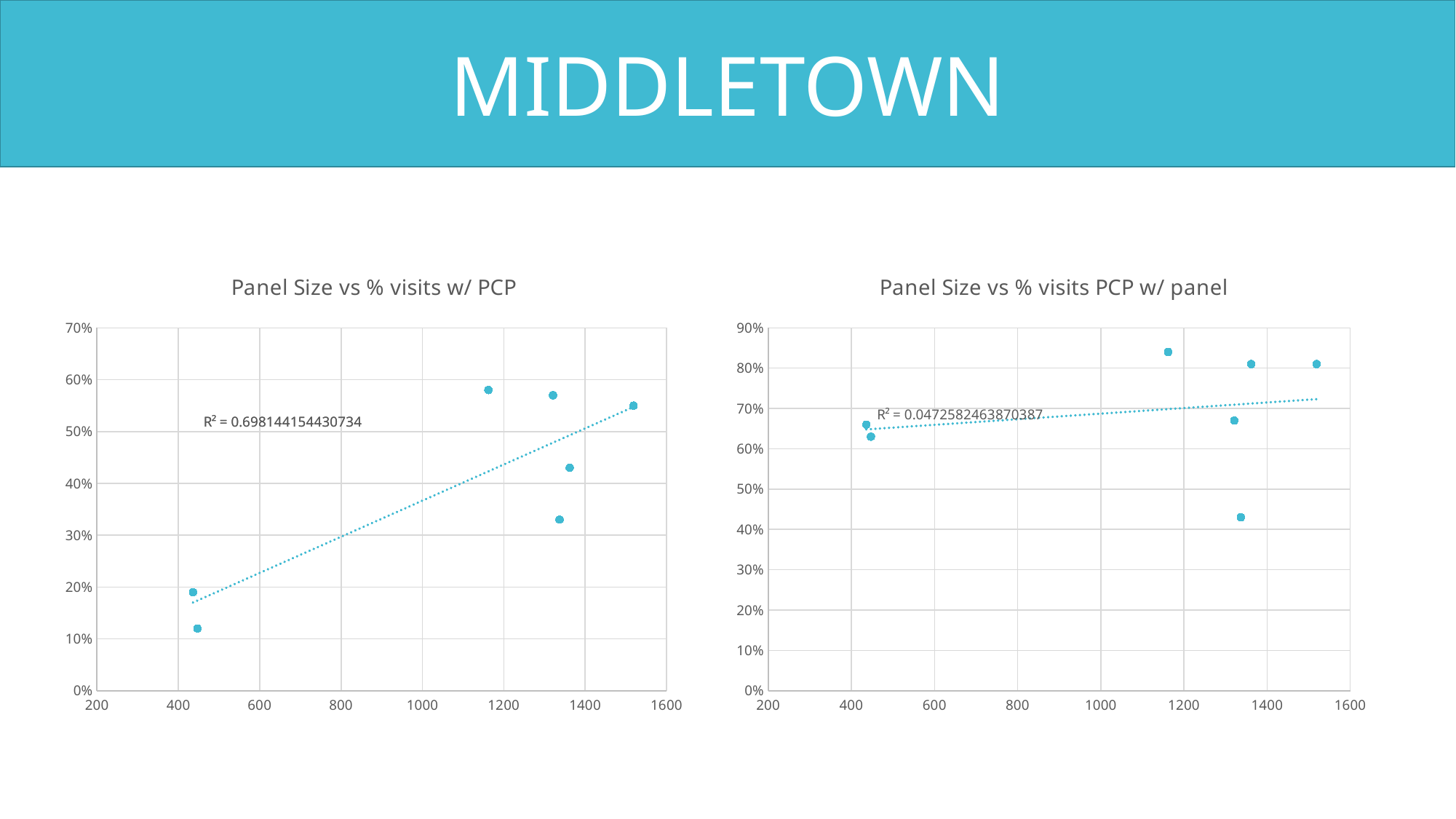
In the right chart, 'Panel Size vs % visits PCP w/ panel', is the value of the lowest point greater or less than 50%? less In the right chart, 'Panel Size vs % visits PCP w/ panel', is the value of the highest point greater or less than 80%? greater What R² value is shown on the left chart, 'Panel Size vs % visits w/ PCP'? R² = 0.698144154430734 What is the maximum value shown on the y axis of the right chart, 'Panel Size vs % visits PCP w/ panel'? 90% How many data points are plotted in the left chart, 'Panel Size vs % visits w/ PCP'? 7 Which chart shows the higher R² value, the left chart or the right chart? the left chart What is the title of the left chart? Panel Size vs % visits w/ PCP In the left chart, 'Panel Size vs % visits w/ PCP', is the value of the lowest point greater or less than 20%? less In the left chart, 'Panel Size vs % visits w/ PCP', does the dotted trend line rise or fall as panel size increases? rise What kind of chart is the left chart, 'Panel Size vs % visits w/ PCP'? scatter chart How many data points are plotted in the right chart, 'Panel Size vs % visits PCP w/ panel'? 7 What R² value is shown on the right chart, 'Panel Size vs % visits PCP w/ panel'? R² = 0.0472582463870387